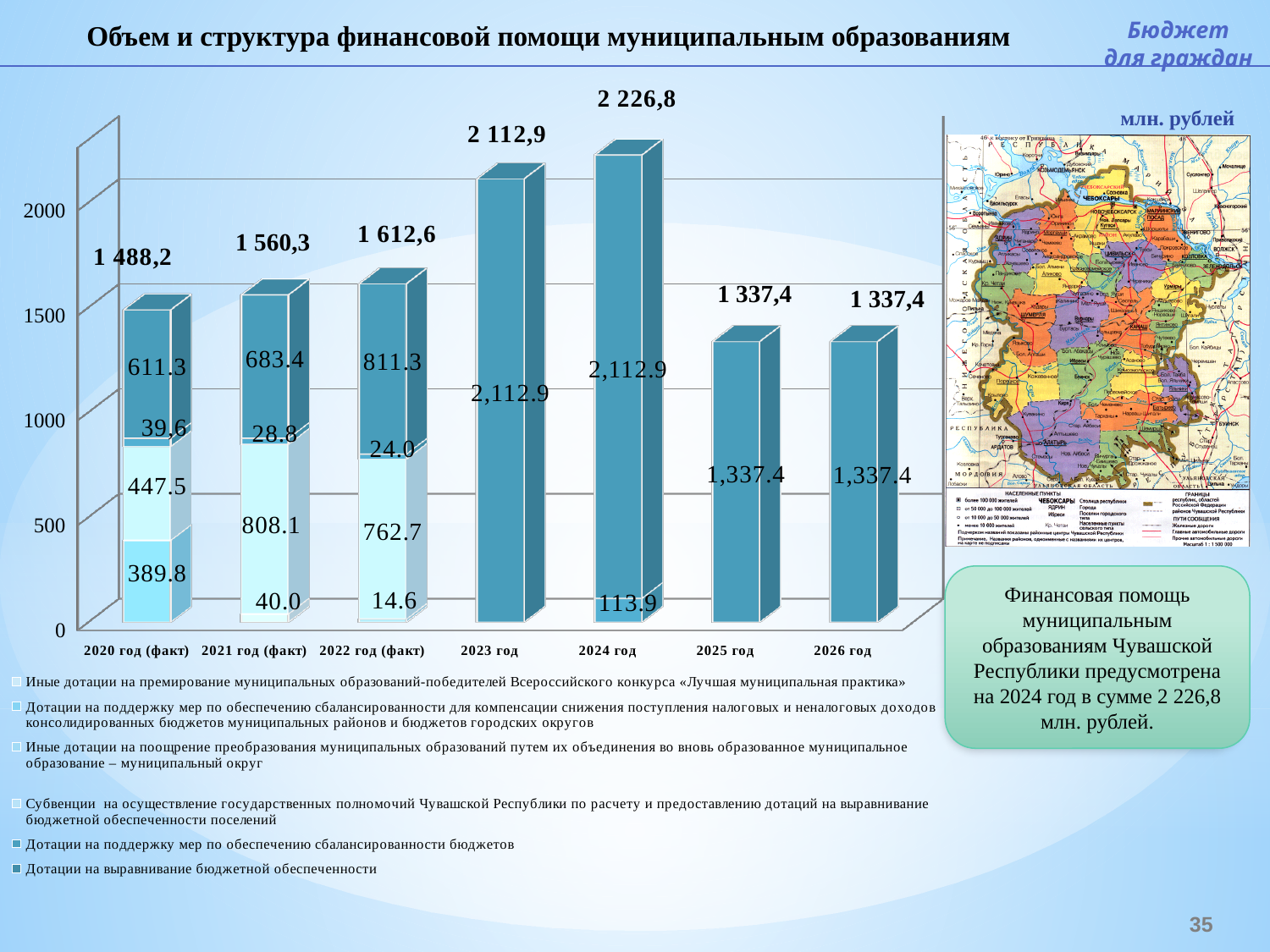
What kind of chart is shown on the slide? Stacked bar chart What is the difference between the totals for 2024 год and 2023 год? 113,9 How many year categories are shown on the x axis? 7 Which total is larger, 2021 год (факт) or 2022 год (факт)? 2022 год (факт) What unit is indicated for the chart values? млн. рублей What is the total value shown above the bar for 2020 год (факт)? 1 488,2 What is the total value shown above the bar for 2022 год (факт)? 1 612,6 What is the total value shown above the bar for 2024 год? 2 226,8 How many series does the legend list? 6 What is the value of the largest segment in the 2020 год (факт) bar? 611.3 Which years have the lowest total financial assistance? 2025 год and 2026 год Which year has the highest total financial assistance? 2024 год